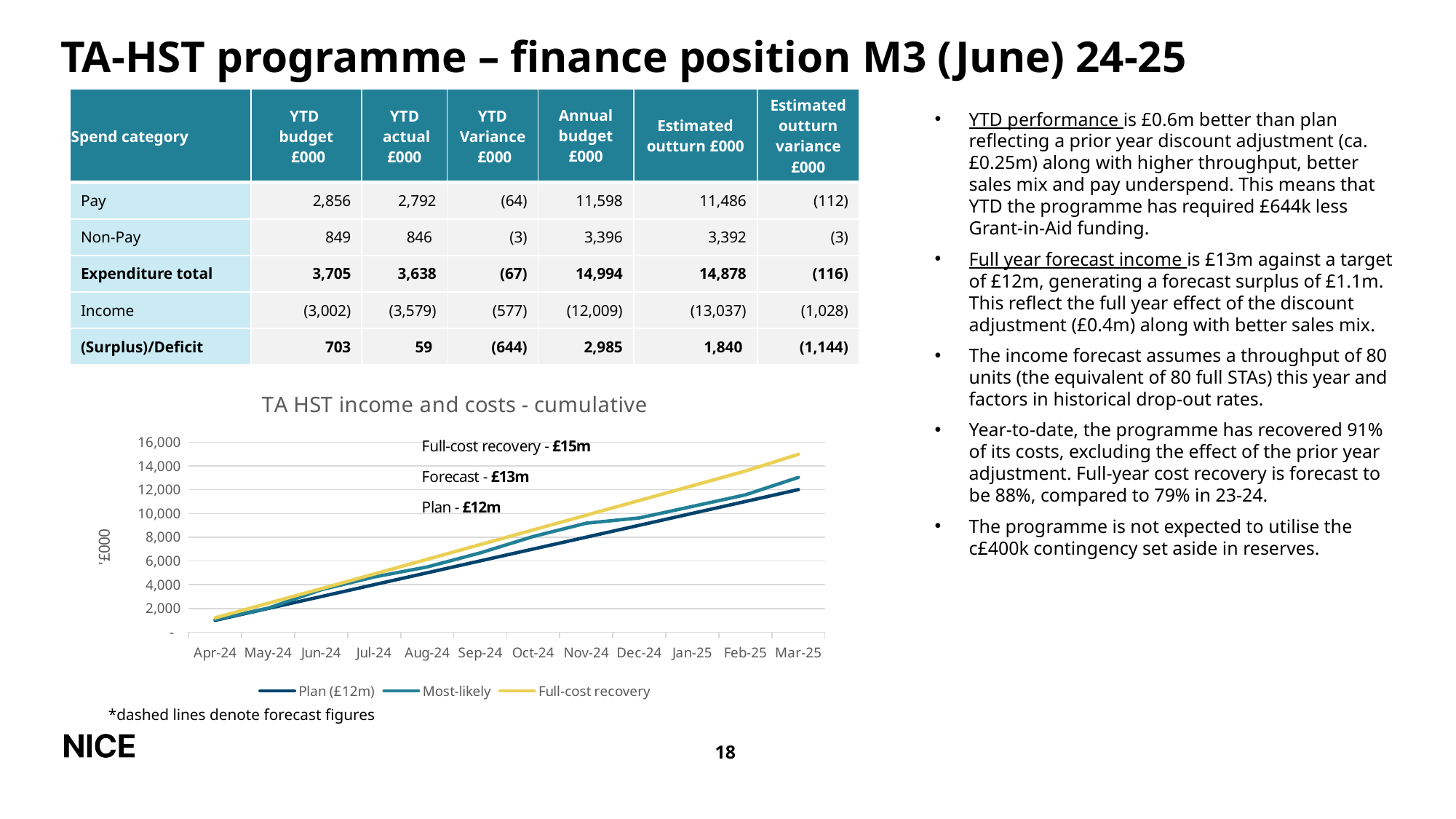
How many series does the legend of the 'TA HST income and costs - cumulative' chart list? 3 How many months are shown on the x axis of the 'TA HST income and costs - cumulative' chart? 12 In the 'TA HST income and costs - cumulative' chart, which series is lowest at Mar-25? Plan (£12m) What kind of chart is 'TA HST income and costs - cumulative'? line chart What unit is shown on the y axis of the 'TA HST income and costs - cumulative' chart? '£000 In the 'TA HST income and costs - cumulative' chart, what end value is annotated for Full-cost recovery? £15m In the 'TA HST income and costs - cumulative' chart, which series is highest at Mar-25? Full-cost recovery In the 'TA HST income and costs - cumulative' chart, is the Plan value at Mar-25 greater or less than 14,000? less In the 'TA HST income and costs - cumulative' chart, what end value is annotated for the Forecast? £13m What is the title of the line chart on the slide? TA HST income and costs - cumulative In the 'TA HST income and costs - cumulative' chart, do the series rise or fall from Apr-24 to Mar-25? rise In the 'TA HST income and costs - cumulative' chart, is the Most-likely value at Nov-24 greater or less than 8,000? greater